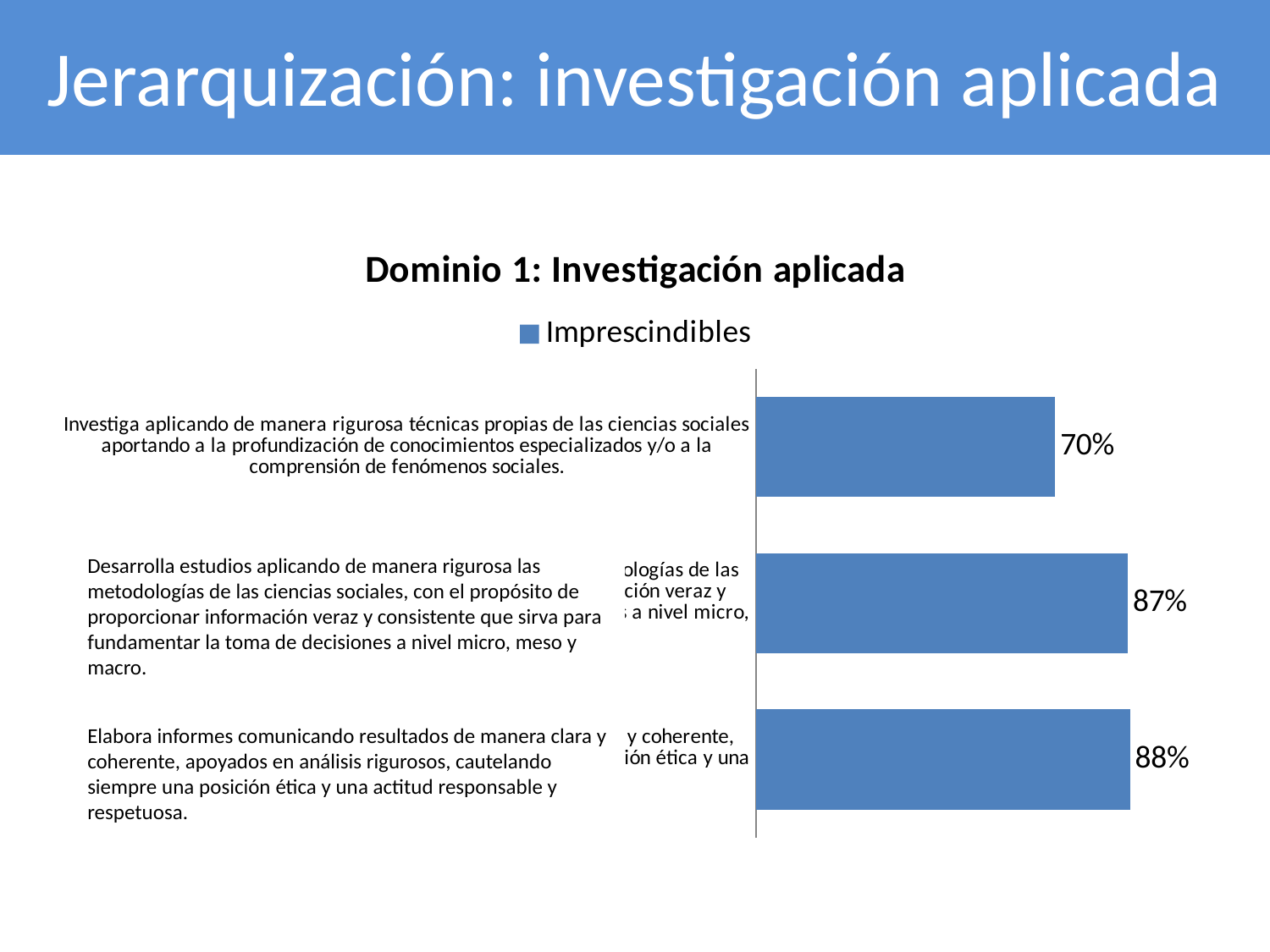
Which category has the highest value? Elabora informes comunicando resultados de manera clara y coherente What is the value for the category beginning 'Desarrolla estudios aplicando de manera rigurosa las metodologías de las ciencias sociales'? 87% What is the difference between the value for 'Desarrolla estudios...' and the value for 'Investiga aplicando...'? 17% What is the difference between the value for 'Elabora informes...' and the value for 'Investiga aplicando...'? 18% What type of chart is shown on the slide? bar chart What is the title of the chart? Dominio 1: Investigación aplicada What is the name of the series shown in the legend? Imprescindibles Which category has the lowest value? Investiga aplicando de manera rigurosa técnicas propias de las ciencias sociales What is the value for the category beginning 'Investiga aplicando de manera rigurosa técnicas propias de las ciencias sociales'? 70% How many categories (bars) does the chart show? 3 What is the value for the category beginning 'Elabora informes comunicando resultados de manera clara y coherente'? 88% How many series does the chart legend list? 1